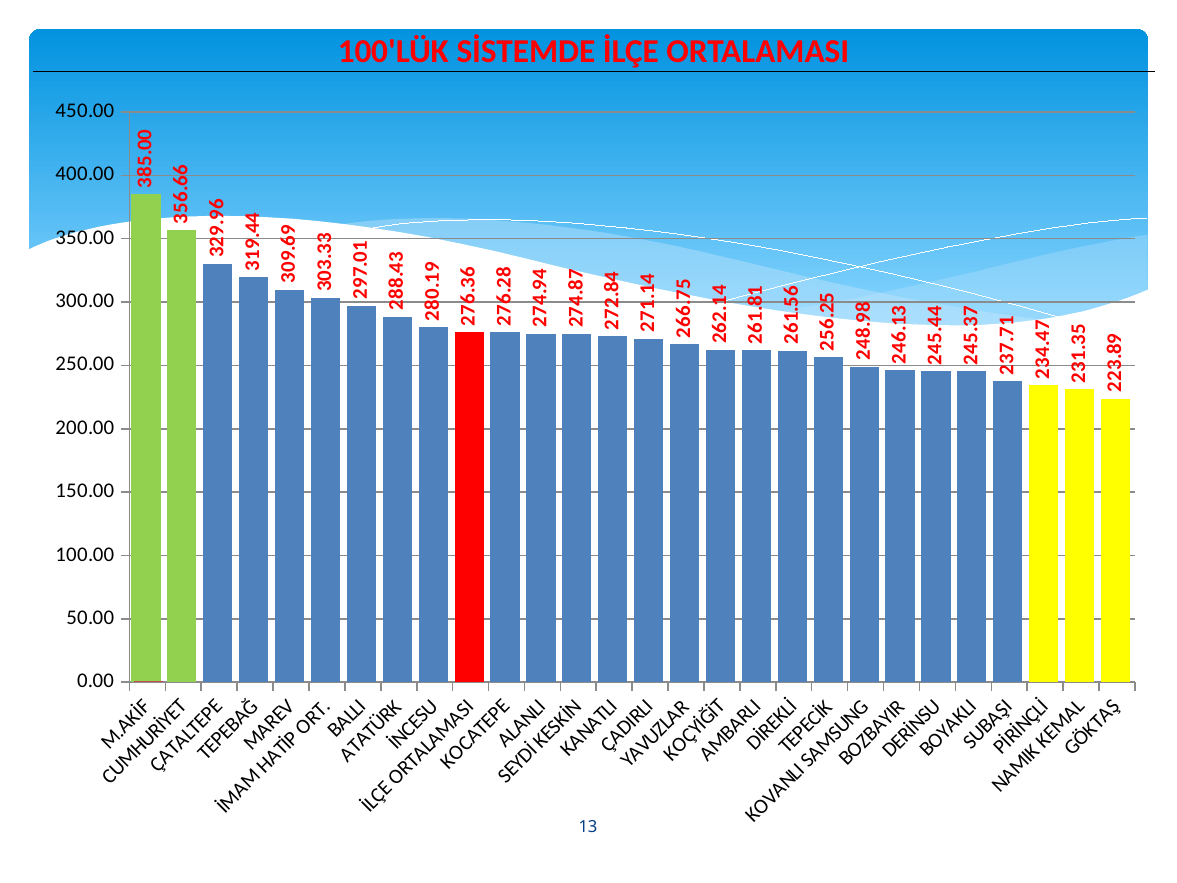
Is the value for SUBAŞI greater or less than 250.00? less How many categories are shown on the x axis? 28 Which category has the lowest value? GÖKTAŞ Which is larger, the value for TEPEBAĞ or the value for MAREV? TEPEBAĞ What kind of chart is shown on the slide? bar chart What is the difference between the values for M.AKİF and CUMHURİYET? 28.34 Which category has the highest value? M.AKİF What is the value for KOVANLI SAMSUNG? 248.98 What is the value for İLÇE ORTALAMASI? 276.36 What is the value for M.AKİF? 385.00 Do the values rise or fall from left to right along the x axis? fall What is the value for GÖKTAŞ? 223.89